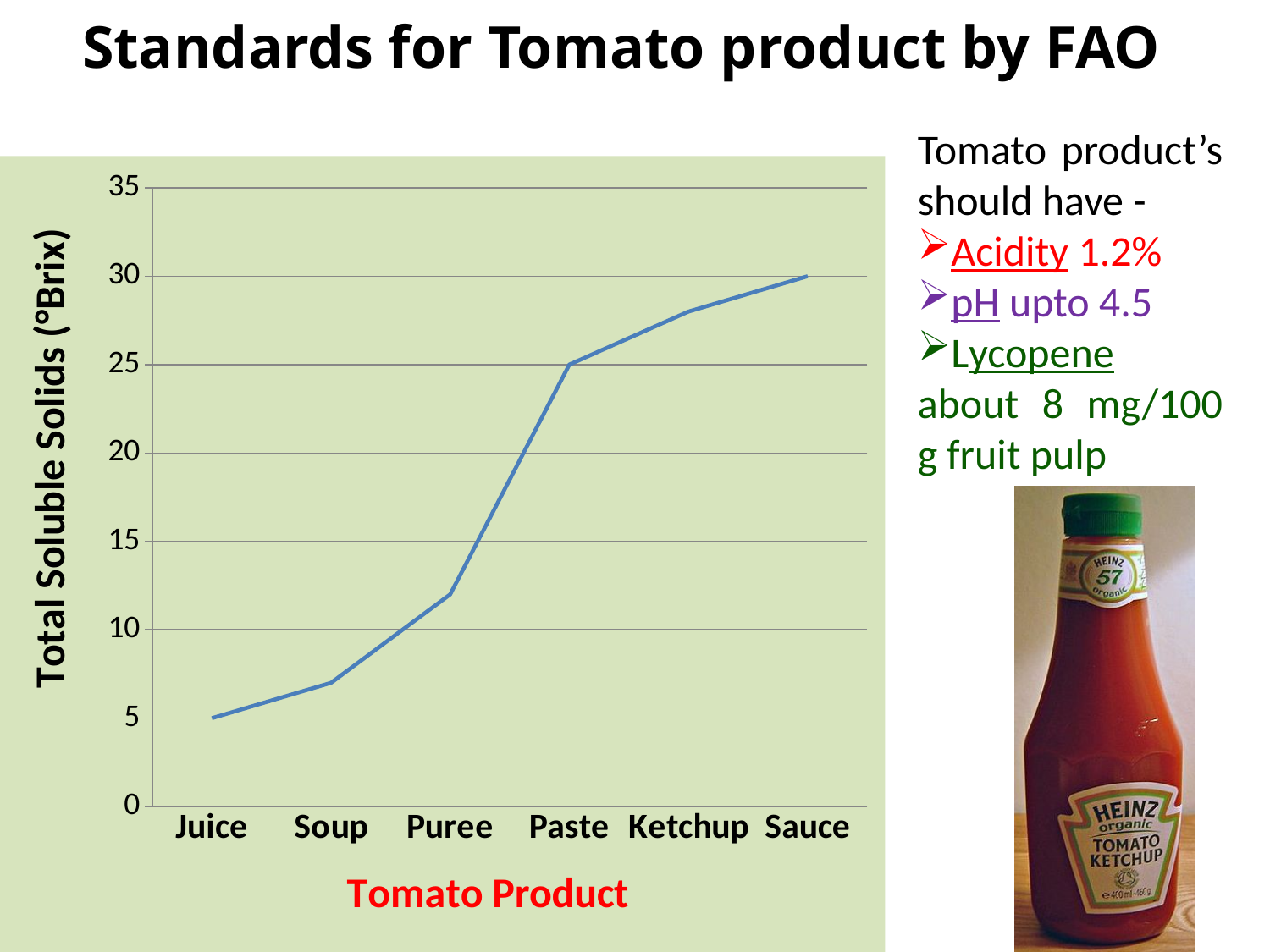
What kind of chart is shown on the slide? Line chart What is the total soluble solids value (°Brix) for Juice? 5 Which tomato product has the lowest total soluble solids? Juice What is the label of the y axis? Total Soluble Solids (°Brix) What is the difference in total soluble solids between Sauce and Juice? 25 Do the total soluble solids values rise or fall from Juice to Sauce along the x axis? Rise How many tomato products are plotted on the x axis? 6 Is the value for Soup greater or less than 10? less Is the value for Ketchup greater or less than 25? greater Which tomato product has the highest total soluble solids? Sauce What is the total soluble solids value (°Brix) for Sauce? 30 What is the total soluble solids value (°Brix) for Paste? 25